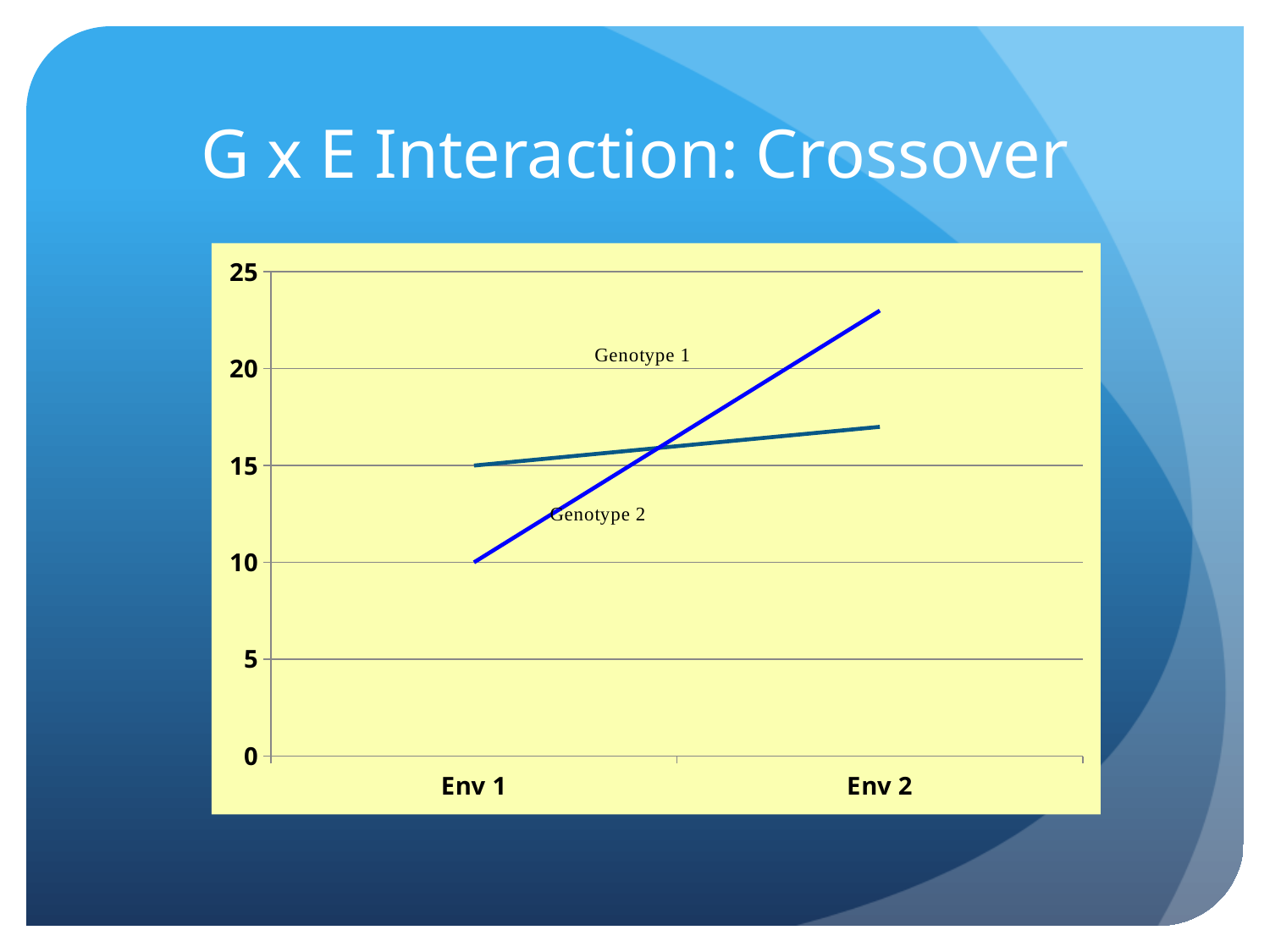
At Env 2, which line has the higher value, the blue line or the dark green line? the blue line Is the value of the dark green line at Env 2 greater or less than 20? less What is the title of the slide containing the chart? G x E Interaction: Crossover At Env 1, which line has the higher value, the blue line or the dark green line? the dark green line Does the blue line rise or fall from Env 1 to Env 2? rise What is the value of the blue line at Env 1? 10 How many lines are plotted on the chart? 2 Is the value of the blue line at Env 2 greater or less than 20? greater What is the value of the dark green line at Env 1? 15 What is the difference between the dark green line and the blue line at Env 1? 5 What kind of chart is shown on the slide? line chart How many categories are shown on the x axis of the chart? 2